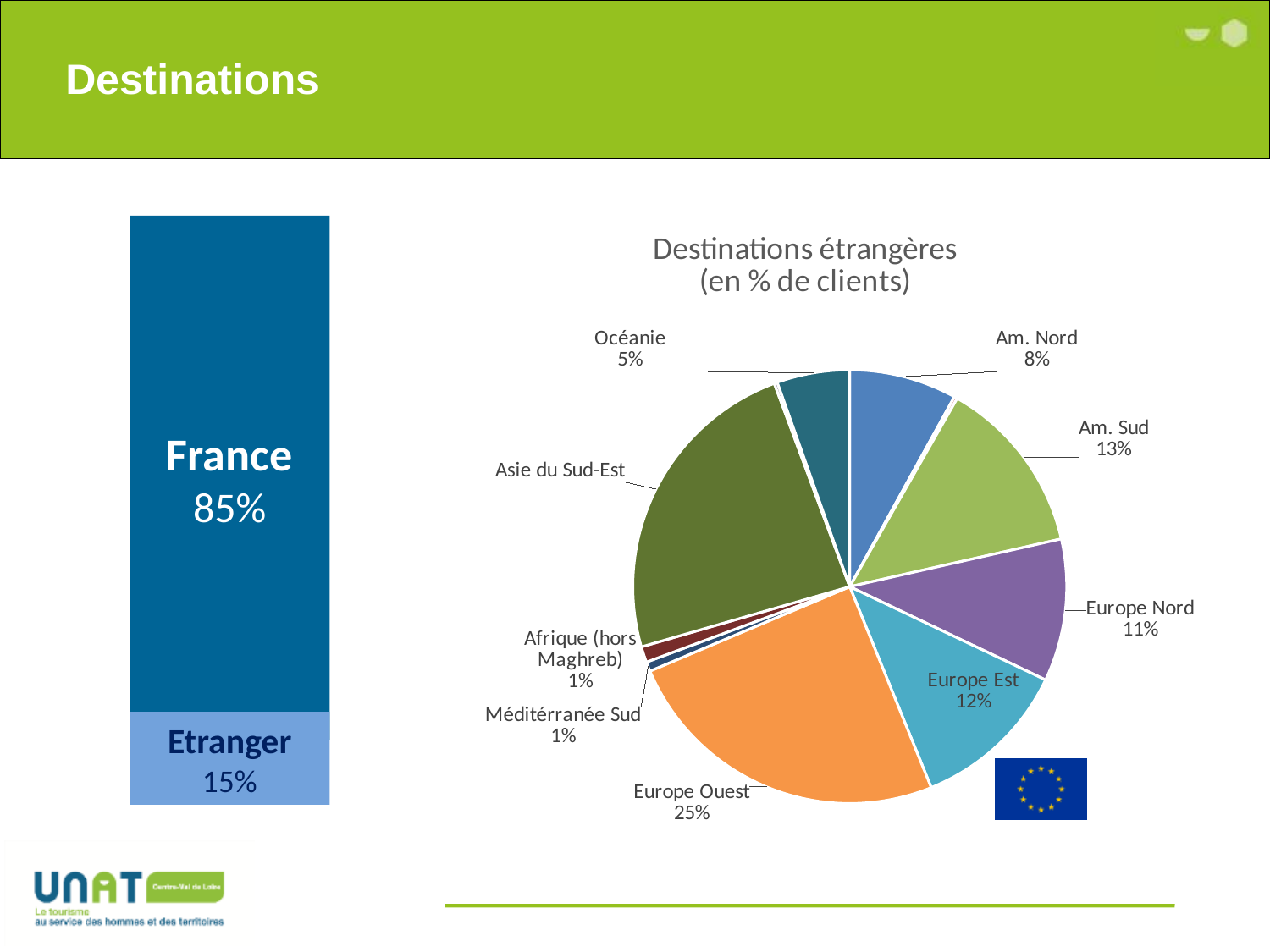
In the pie chart 'Destinations étrangères', which has the larger share, Europe Nord or Europe Est? Europe Est In the pie chart 'Destinations étrangères', which has the larger share, Am. Nord or Am. Sud? Am. Sud In the pie chart 'Destinations étrangères', what percentage is shown for Am. Sud? 13% In the pie chart 'Destinations étrangères', what percentage is shown for Europe Est? 12% In the pie chart 'Destinations étrangères', what is the difference between the Europe Ouest and Europe Est percentages? 13% In the bar chart on the left of the slide, what percentage is shown for France? 85% In the pie chart 'Destinations étrangères', what percentage is shown for Europe Ouest? 25% What kind of chart is the chart titled 'Destinations étrangères'? Pie chart In the bar chart on the left of the slide, what percentage is shown for Etranger? 15% In the pie chart 'Destinations étrangères', what percentage is shown for Océanie? 5% In the pie chart 'Destinations étrangères', what is the difference between the Am. Sud and Am. Nord percentages? 5%